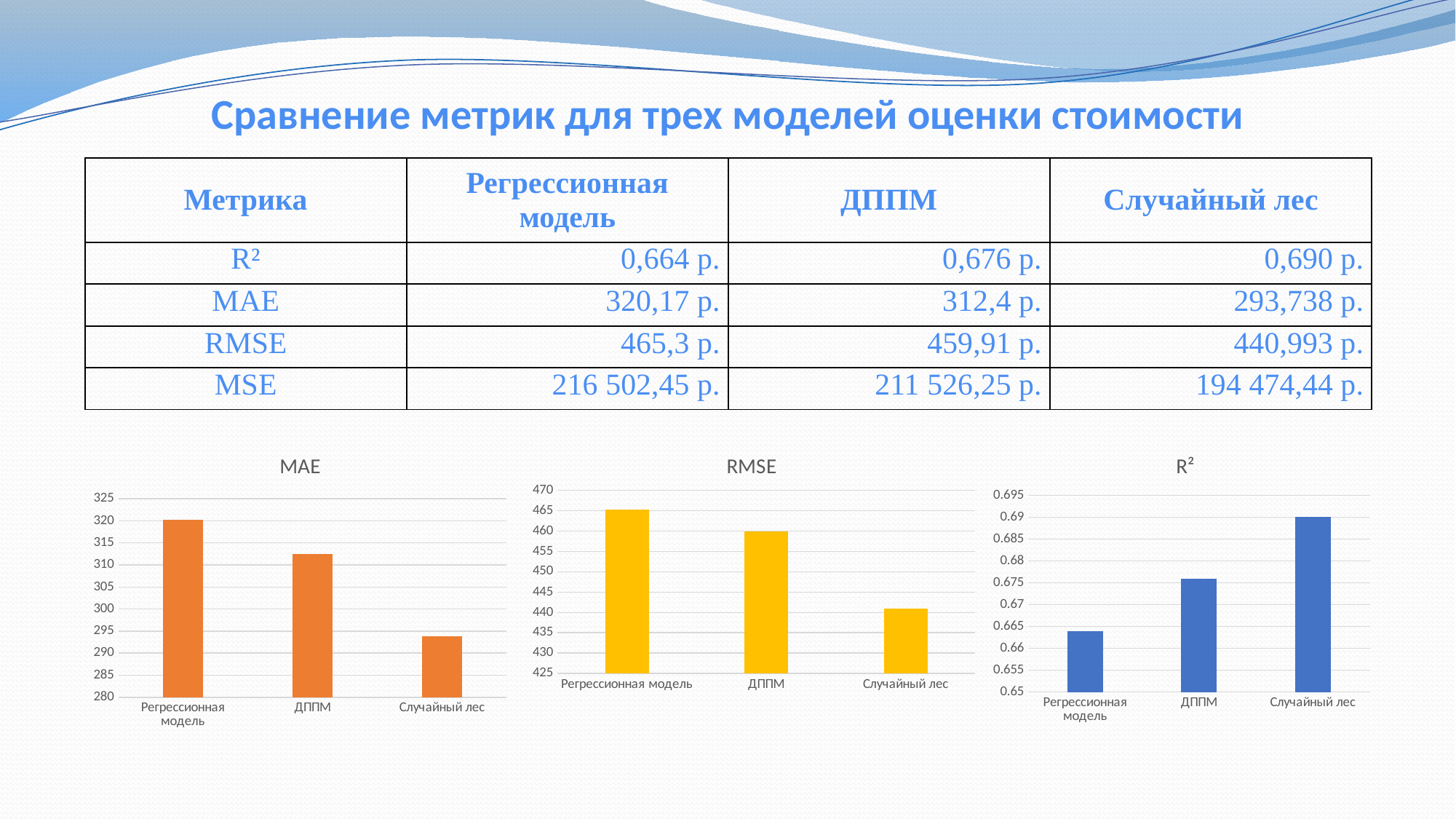
In the RMSE chart, is the value for Случайный лес greater or less than 445? less In the MAE chart, is the value for ДППМ greater or less than 310? greater In the R² chart, what is the R² value for Случайный лес, as printed in the table? 0,690 р. In the MAE chart, which is larger: the MAE for Регрессионная модель or for ДППМ? Регрессионная модель What kind of chart is the MAE chart? bar chart What colour are the bars in the RMSE chart? yellow In the R² chart, which model has the highest R²? Случайный лес In the MAE chart, do the values rise or fall from left to right across the models? fall How many models (categories) are shown in the RMSE chart? 3 In the RMSE chart, which model has the highest RMSE? Регрессионная модель In the MAE chart, which model has the lowest MAE? Случайный лес